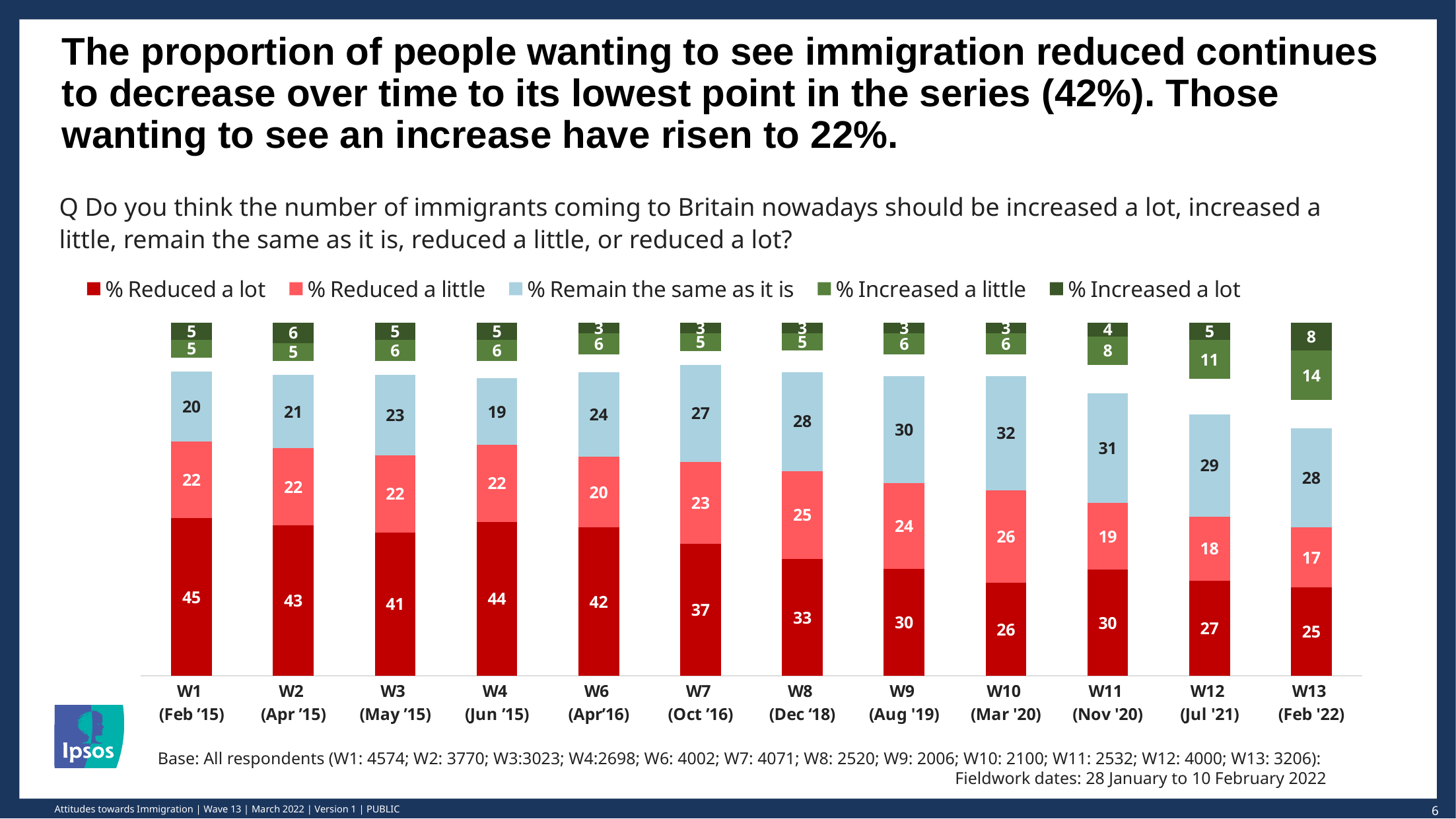
Does % Increased a little rise or fall from W10 (Mar '20) to W13 (Feb '22)? Rise What is the value for % Increased a little at W13 (Feb '22)? 14 Which is larger: % Remain the same as it is at W7 (Oct '16) or at W1 (Feb '15)? W7 (Oct '16) How many series does the legend list? 5 What is the total of the stacked bar for W13 (Feb '22)? 92 In which wave is % Reduced a lot lowest? W13 (Feb '22) What is the value for % Remain the same as it is at W10 (Mar '20)? 32 What is the value for % Reduced a lot at W1 (Feb '15)? 45 What is the difference between % Reduced a lot at W1 (Feb '15) and at W13 (Feb '22)? 20 How many waves are shown on the x axis? 12 What kind of chart is shown on the slide? Stacked bar chart In which wave is % Reduced a lot highest? W1 (Feb '15)